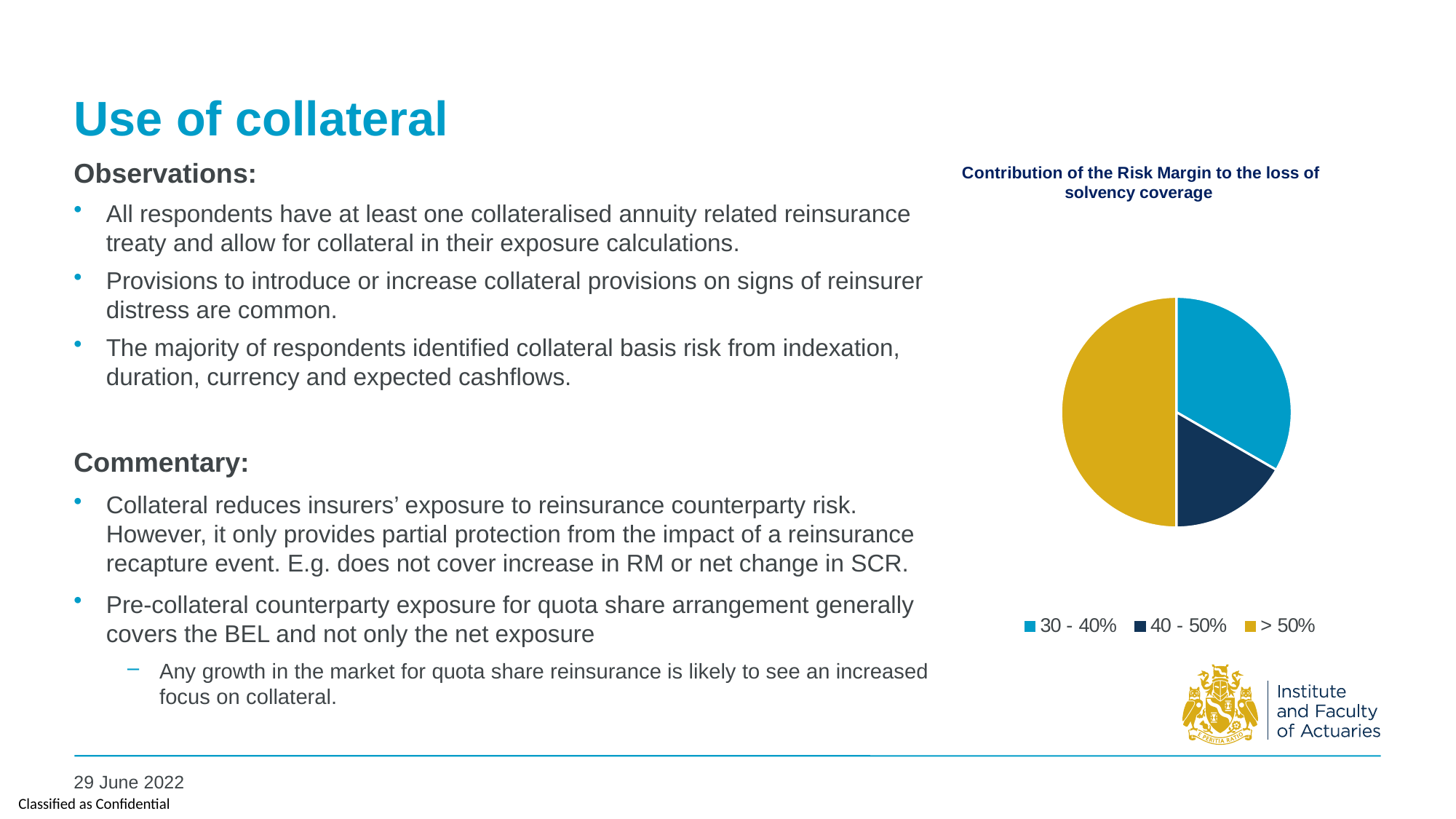
Which category has the smallest slice of the pie? 40 - 50% What is the title of the chart? Contribution of the Risk Margin to the loss of solvency coverage Which slice is larger, > 50% or 40 - 50%? > 50% How many entries does the chart legend list? 3 How many slices does the pie chart have? 3 Which slice is larger, 30 - 40% or 40 - 50%? 30 - 40% What kind of chart is shown on the slide? pie chart What colour is the slice for the > 50% category? gold Which category has the largest slice of the pie? > 50%